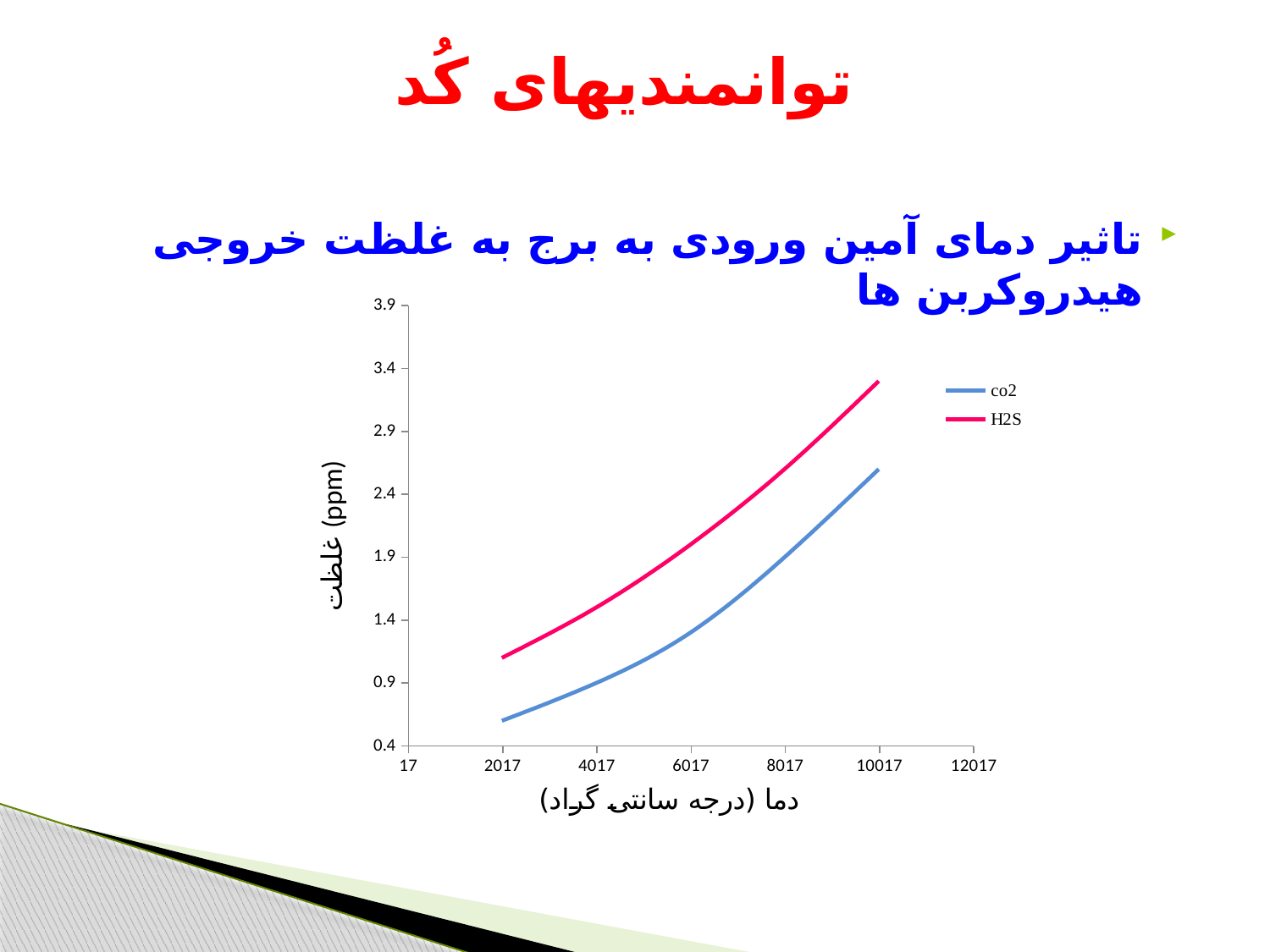
Do the values of the H2S series rise or fall as the x-axis value increases? rise Which two series are listed in the chart's legend? co2 and H2S Is the value for H2S at x = 10017 greater or less than 2.9? greater At x = 2017, which series has the lower value, co2 or H2S? co2 What kind of chart is shown on the slide? line chart Do the values of the co2 series rise or fall as the x-axis value increases? rise How many series does the chart's legend list? 2 At x = 10017, which series has the higher value, co2 or H2S? H2S Is the value for co2 at x = 2017 greater or less than 0.9? less Is the value for H2S at x = 8017 greater or less than 1.9? greater What colour is the H2S line in the chart? red